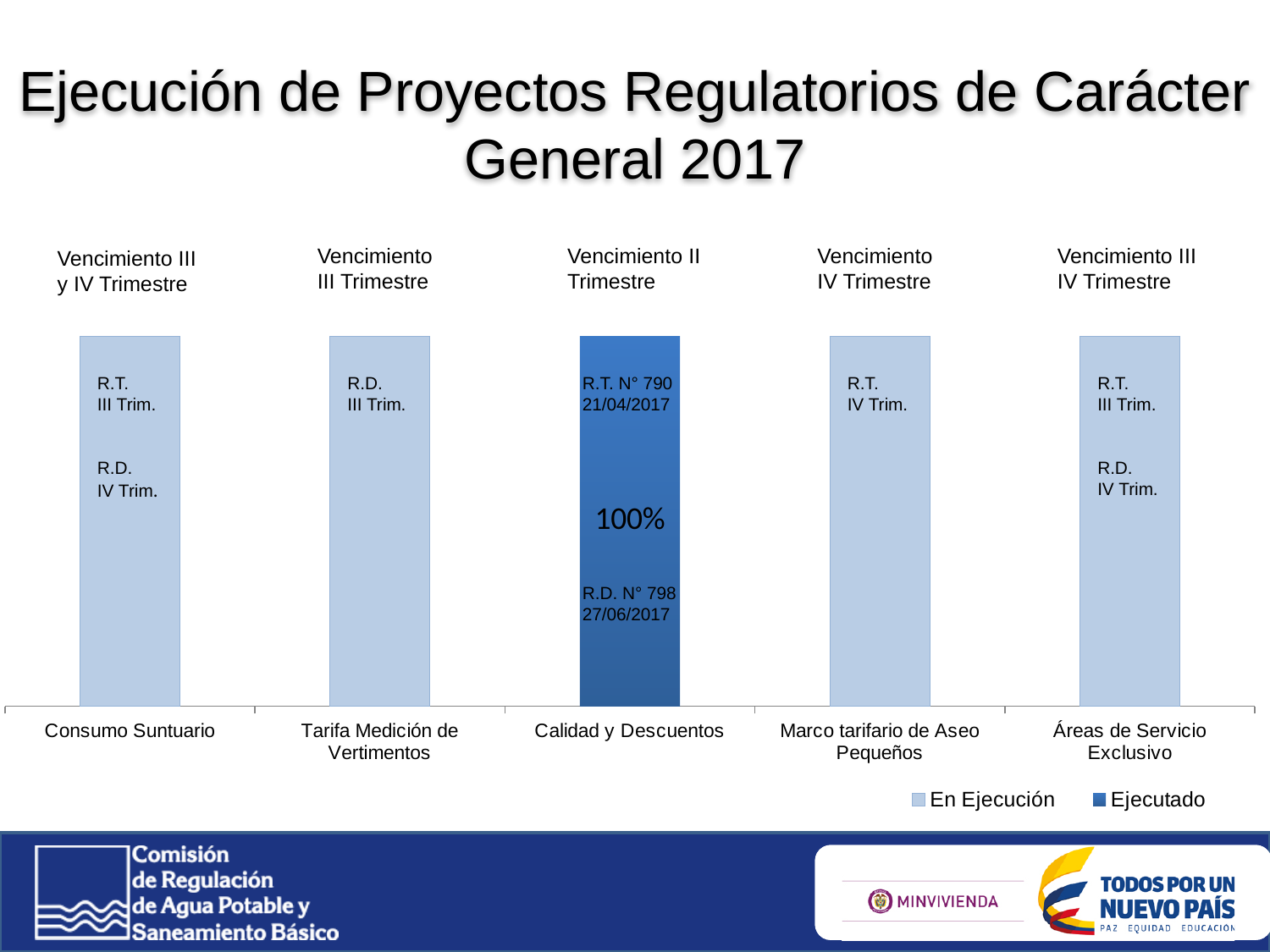
What kind of chart is shown on the slide? bar chart What value is printed on the bar for Calidad y Descuentos? 100% How many categories are shown along the x axis of the chart? 5 How many series does the chart legend list? 2 Which category's bar is shown in the 'Ejecutado' colour? Calidad y Descuentos What are the two series named in the chart legend? En Ejecución, Ejecutado